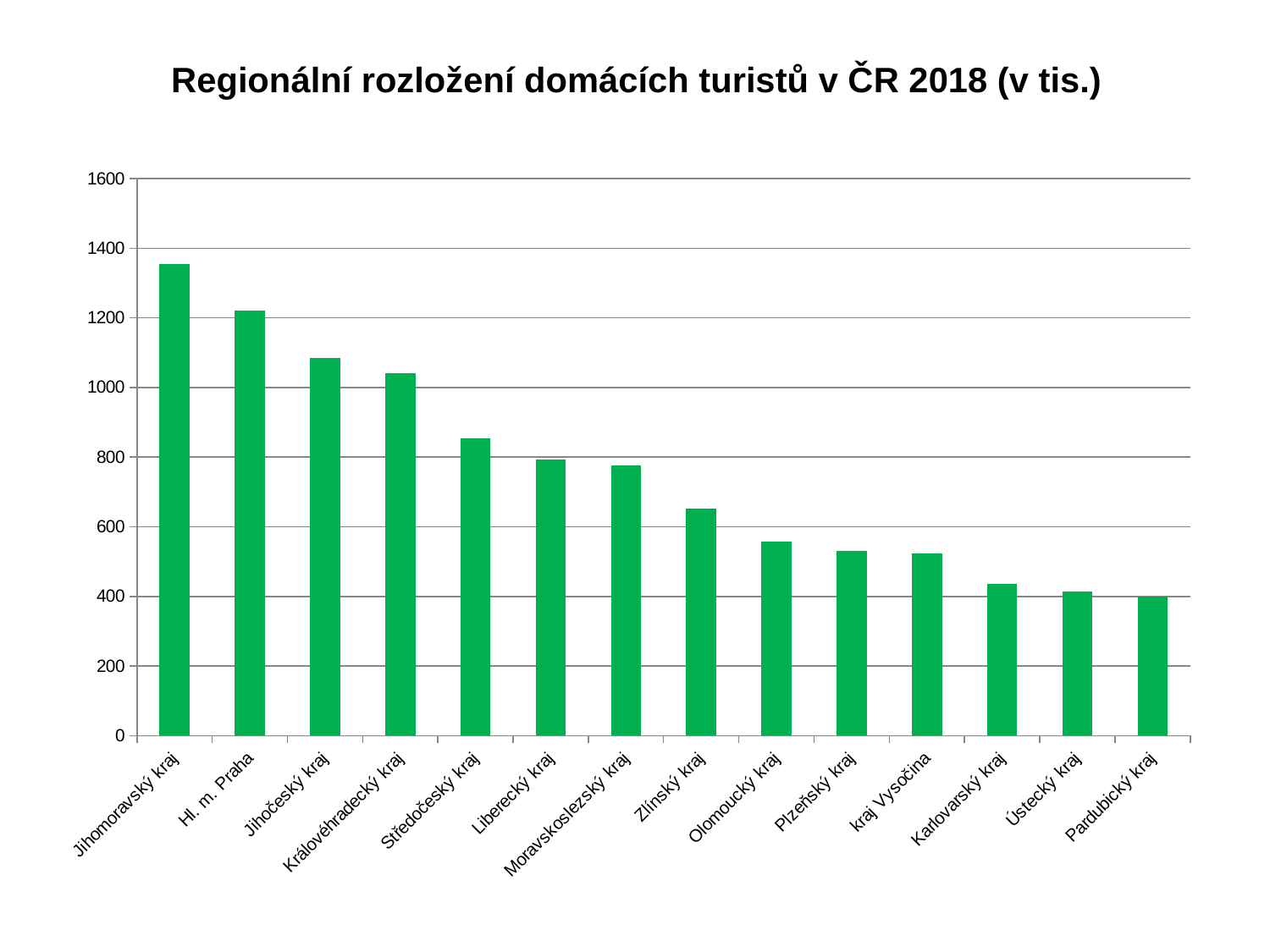
Do the values rise or fall from left to right along the x axis? fall Which region has the highest value in the chart? Jihomoravský kraj Is the value for Hl. m. Praha greater or less than 1200? greater What is the title of the chart? Regionální rozložení domácích turistů v ČR 2018 (v tis.) What type of chart is shown on the slide? bar chart Is the value for Středočeský kraj greater or less than 800? greater Is the value for Karlovarský kraj greater or less than 600? less Which has a larger value, Liberecký kraj or Zlínský kraj? Liberecký kraj How many regions (categories) are plotted in the chart? 14